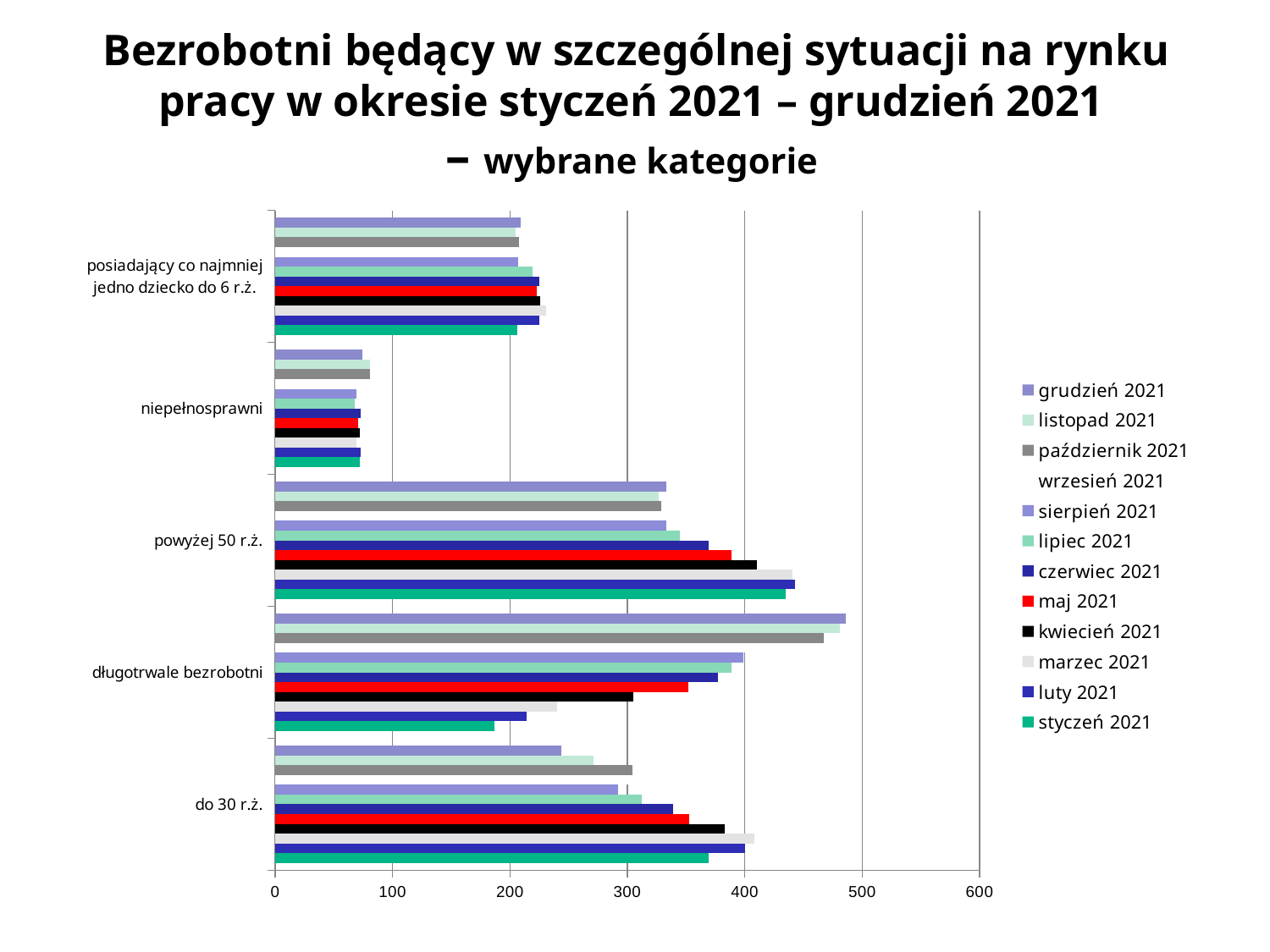
For długotrwale bezrobotni, which is larger: the value for grudzień 2021 or for styczeń 2021? grudzień 2021 Within the category 'długotrwale bezrobotni', which month has the lowest value? styczeń 2021 Which colour represents maj 2021 in the legend? red What kind of chart is shown on the slide? bar chart Is the value for długotrwale bezrobotni in grudzień 2021 greater or less than 400? greater Within the category 'do 30 r.ż.', which month has the lowest value? grudzień 2021 How many categories are shown on the vertical axis of the chart? 5 Which category contains the single highest bar in the chart? długotrwale bezrobotni Is the value for niepełnosprawni in grudzień 2021 greater or less than 100? less How many series does the legend list? 12 Is the value for do 30 r.ż. in styczeń 2021 greater or less than 300? greater Which category has the lowest values across all months? niepełnosprawni